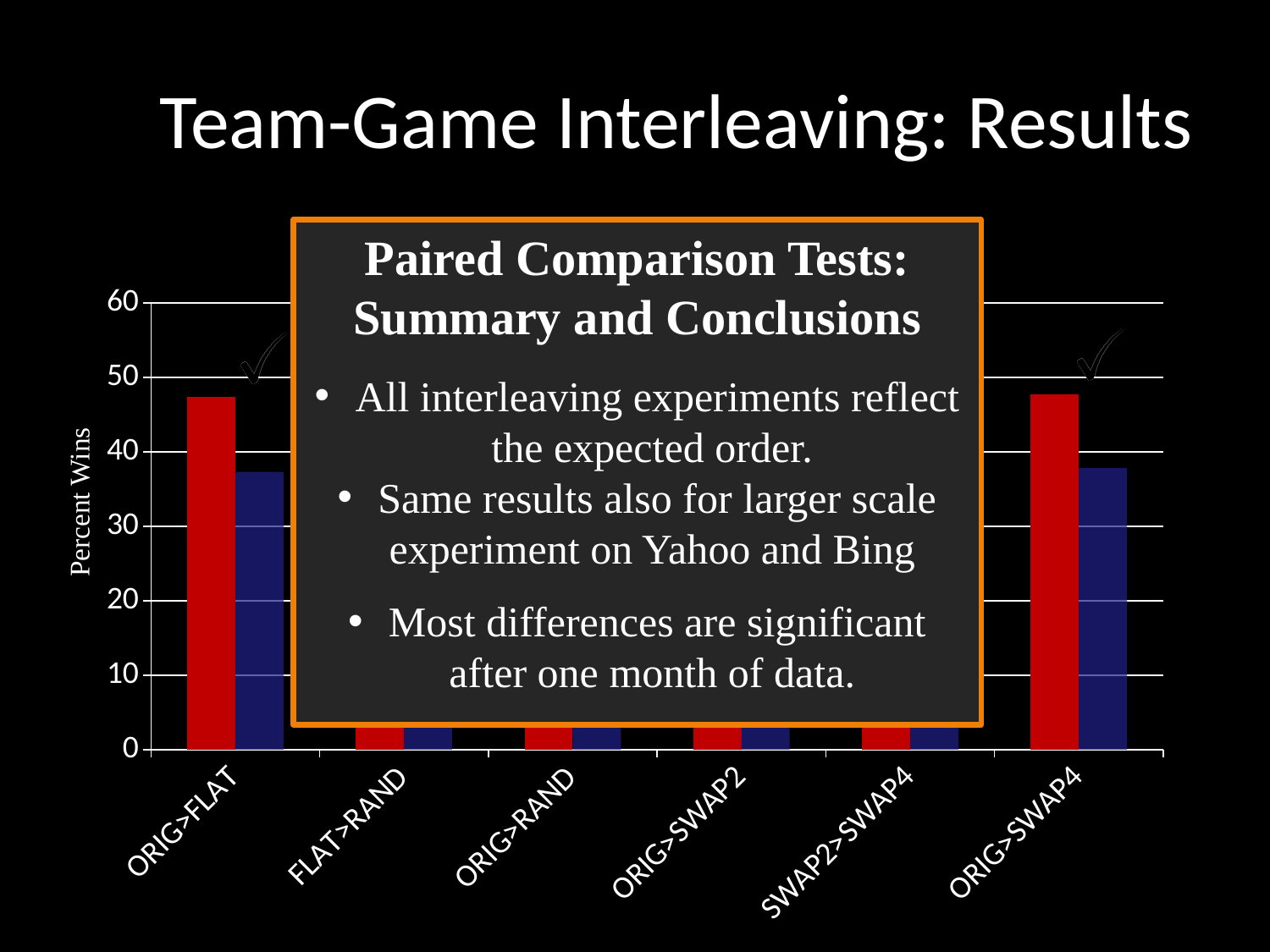
What kind of chart is shown on the slide? bar chart How many bars are plotted for each category in the chart? 2 For ORIG>FLAT, which bar is taller, the red bar or the blue bar? the red bar For ORIG>SWAP4, which bar is taller, the red bar or the blue bar? the red bar How many categories are shown on the x axis of the chart? 6 Is the value of the red bar for ORIG>FLAT greater or less than 50? less Is the value of the red bar for ORIG>SWAP4 greater or less than 40? greater Is the value of the blue bar for ORIG>FLAT greater or less than 40? less What is the label of the y axis of the chart? Percent Wins What is the highest tick value shown on the y axis of the chart? 60